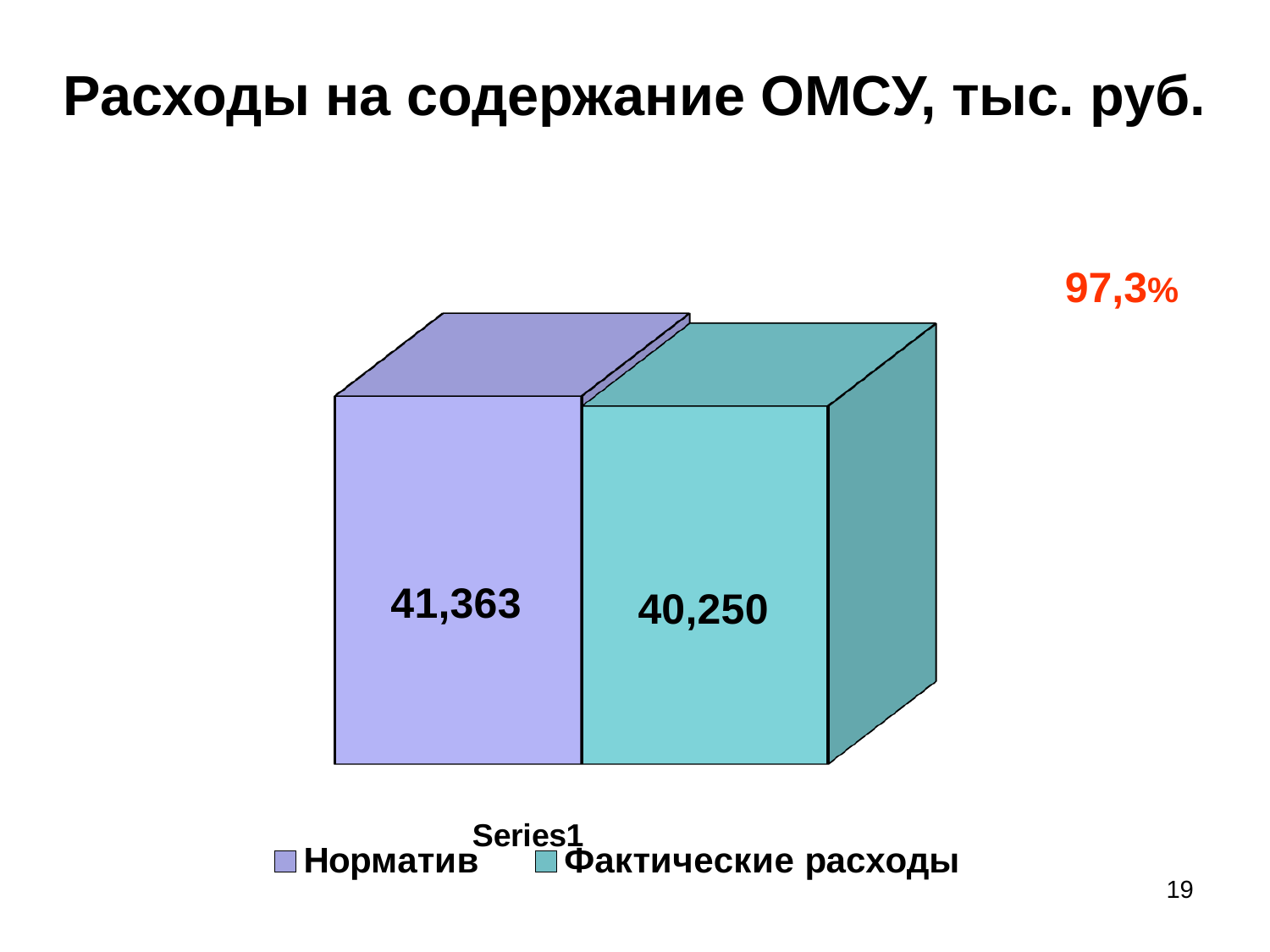
How many series does the legend list? 2 What is the title of the chart? Расходы на содержание ОМСУ, тыс. руб. Which series has the lowest value? Фактические расходы What is the value for Норматив? 41,363 What is the value for Фактические расходы? 40,250 What kind of chart is shown on the slide? Bar chart Which series has the highest value? Норматив Which series has the higher value, Норматив or Фактические расходы? Норматив What percentage is shown in red at the top right of the chart? 97,3% How many bars are plotted on the chart? 2 What is the difference between the Норматив value and the Фактические расходы value? 1,113